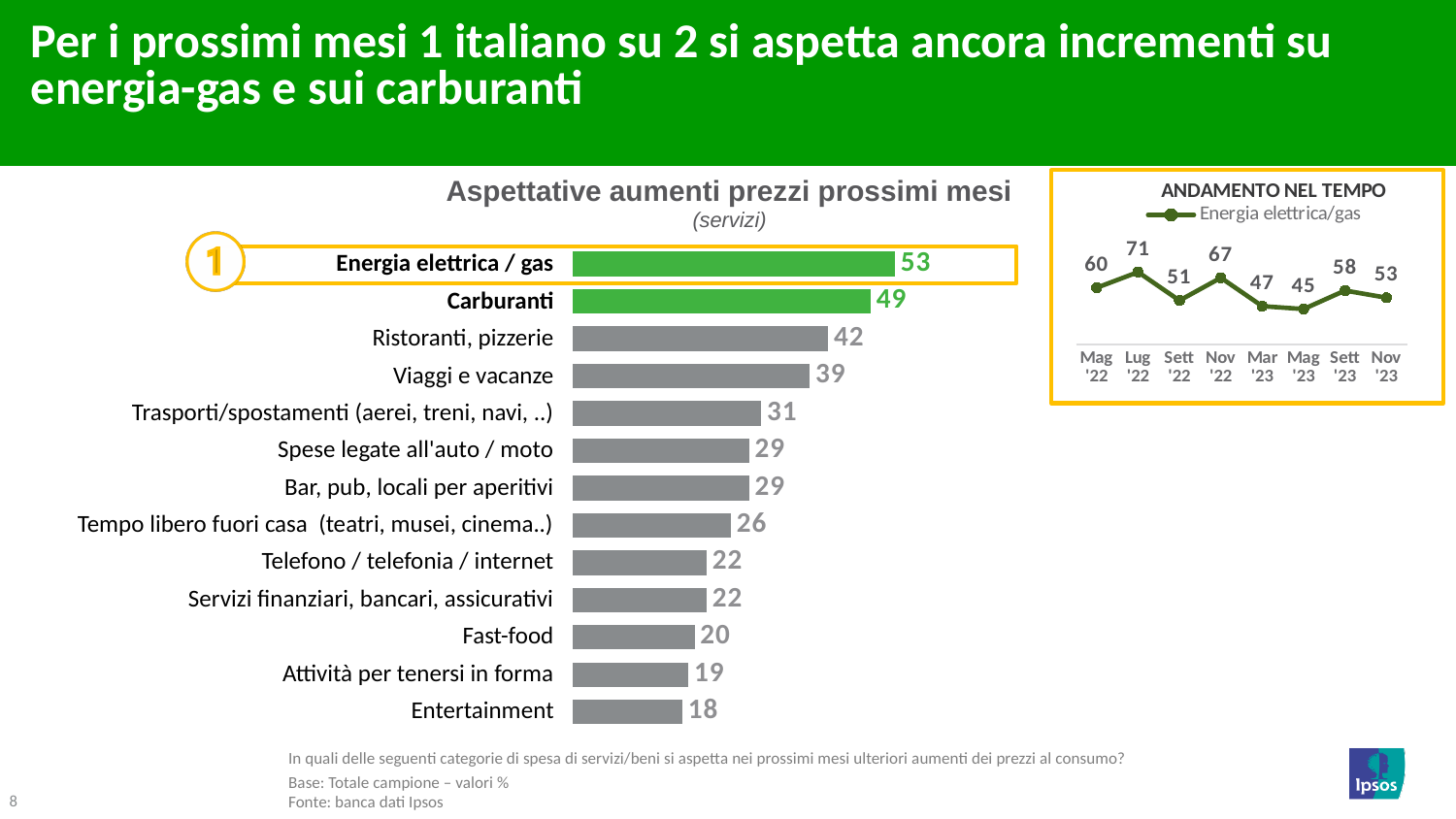
In the 'Aspettative aumenti prezzi prossimi mesi' chart, which is larger: Trasporti/spostamenti (aerei, treni, navi, ..) or Fast-food? Trasporti/spostamenti (aerei, treni, navi, ..) How many data points are plotted in the 'ANDAMENTO NEL TEMPO' chart? 8 In the 'Aspettative aumenti prezzi prossimi mesi' chart, what is the value for Carburanti? 49 In the 'ANDAMENTO NEL TEMPO' chart, which period has the lowest value? Mag '23 In the 'Aspettative aumenti prezzi prossimi mesi' chart, what is the value for Viaggi e vacanze? 39 In the 'Aspettative aumenti prezzi prossimi mesi' chart, which category has the lowest value? Entertainment In the 'ANDAMENTO NEL TEMPO' chart, what is the value for Lug '22? 71 What kind of chart is 'Aspettative aumenti prezzi prossimi mesi'? Bar chart In the 'Aspettative aumenti prezzi prossimi mesi' chart, what is the difference between Energia elettrica / gas and Ristoranti, pizzerie? 11 How many categories are shown in the 'Aspettative aumenti prezzi prossimi mesi' chart? 13 In the 'Aspettative aumenti prezzi prossimi mesi' chart, which category has the highest value? Energia elettrica / gas In the 'ANDAMENTO NEL TEMPO' chart, what is the difference between the Sett '23 and Nov '23 values? 5